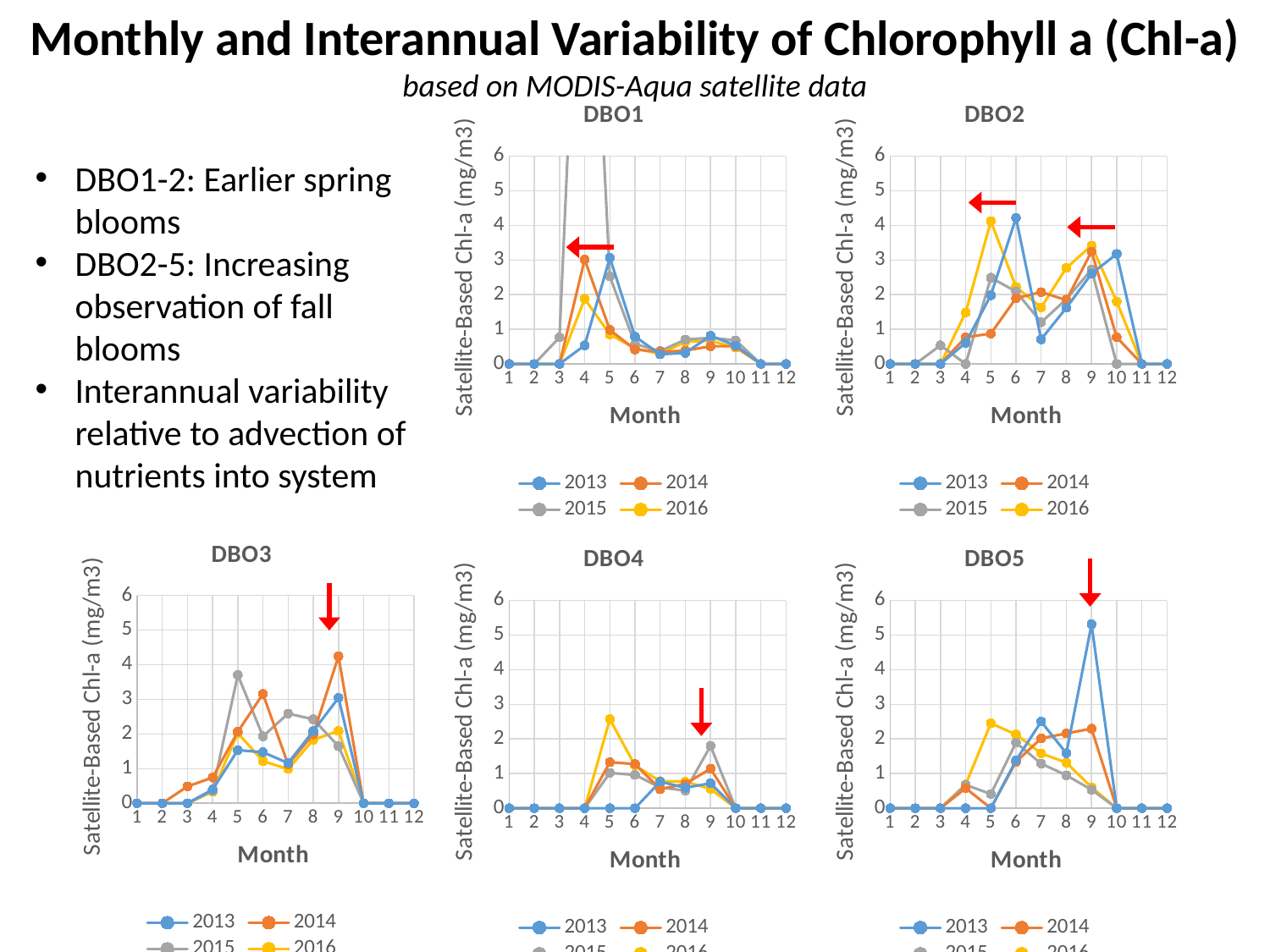
In the DBO2 chart, is the 2016 value in month 5 greater or less than 3? greater In the DBO4 chart, is the 2016 value in month 5 greater or less than 2? greater In the DBO2 chart, which year has the highest value in month 6? 2013 How many series does the legend of the DBO2 chart list? 4 What kind of chart is the DBO1 chart? line chart How many months are shown on the x axis of the DBO3 chart? 12 In the DBO3 chart, which year has the highest value in month 5? 2015 In the DBO5 chart, is the 2013 value in month 9 greater or less than 4? greater What is the y-axis label of the DBO4 chart? Satellite-Based Chl-a (mg/m3) In the DBO5 chart, which year has the highest value in month 9? 2013 In the DBO3 chart, does the 2014 line rise or fall from month 7 to month 9? rise